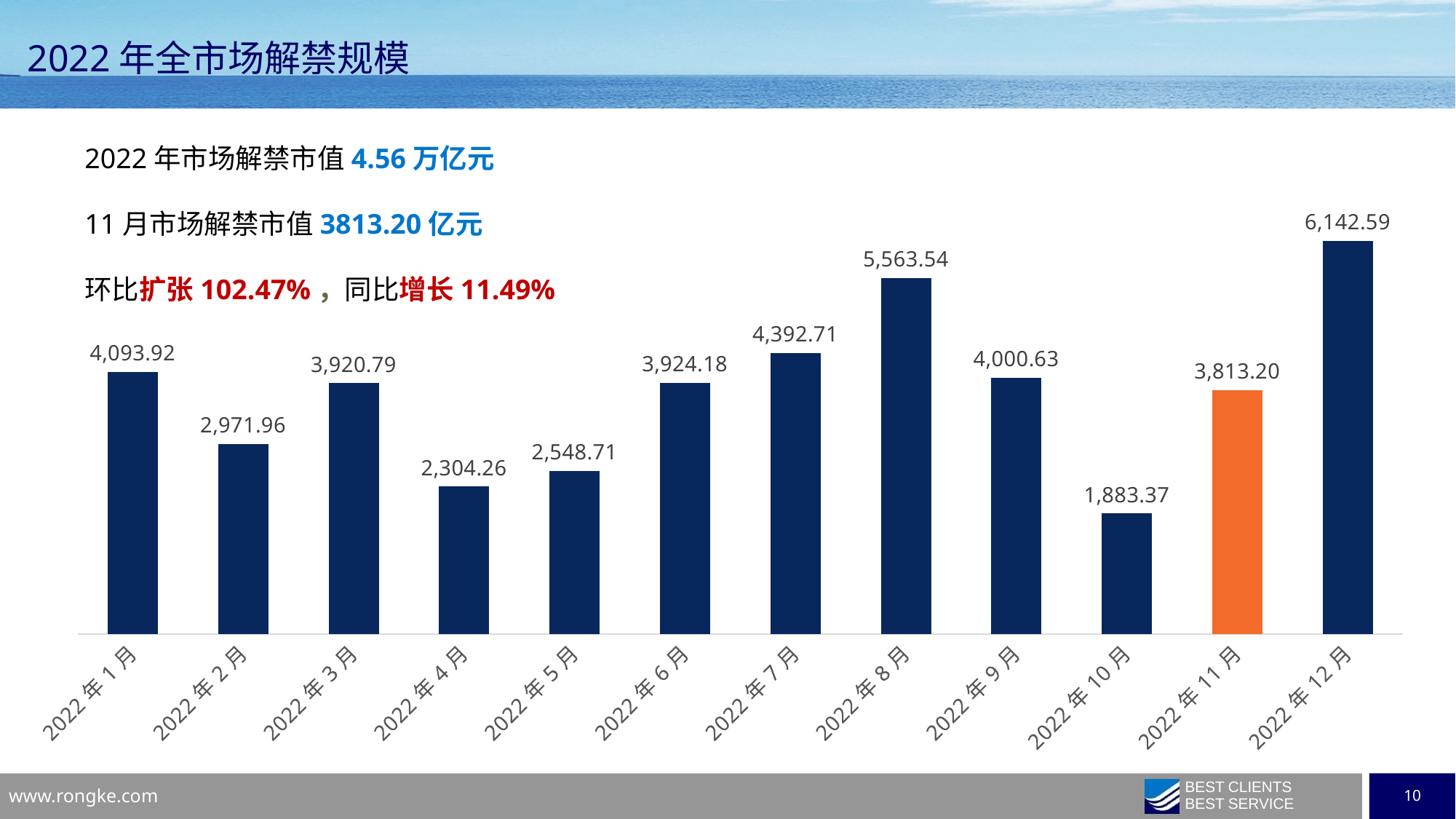
What is the difference between the values for 2022年12月 and 2022年11月? 2,329.39 What is the value for 2022年11月? 3,813.20 What kind of chart is shown on the slide? Bar chart What is the value for 2022年4月? 2,304.26 Which month has the highest value? 2022年12月 What is the difference between the values for 2022年8月 and 2022年7月? 1,170.83 Which month has the lowest value? 2022年10月 How many months are shown in the chart? 12 Which is larger, the value for 2022年2月 or 2022年5月? 2022年2月 What is the value for 2022年8月? 5,563.54 Do the values rise or fall from 2022年8月 to 2022年10月? Fall Which month's bar is coloured orange? 2022年11月